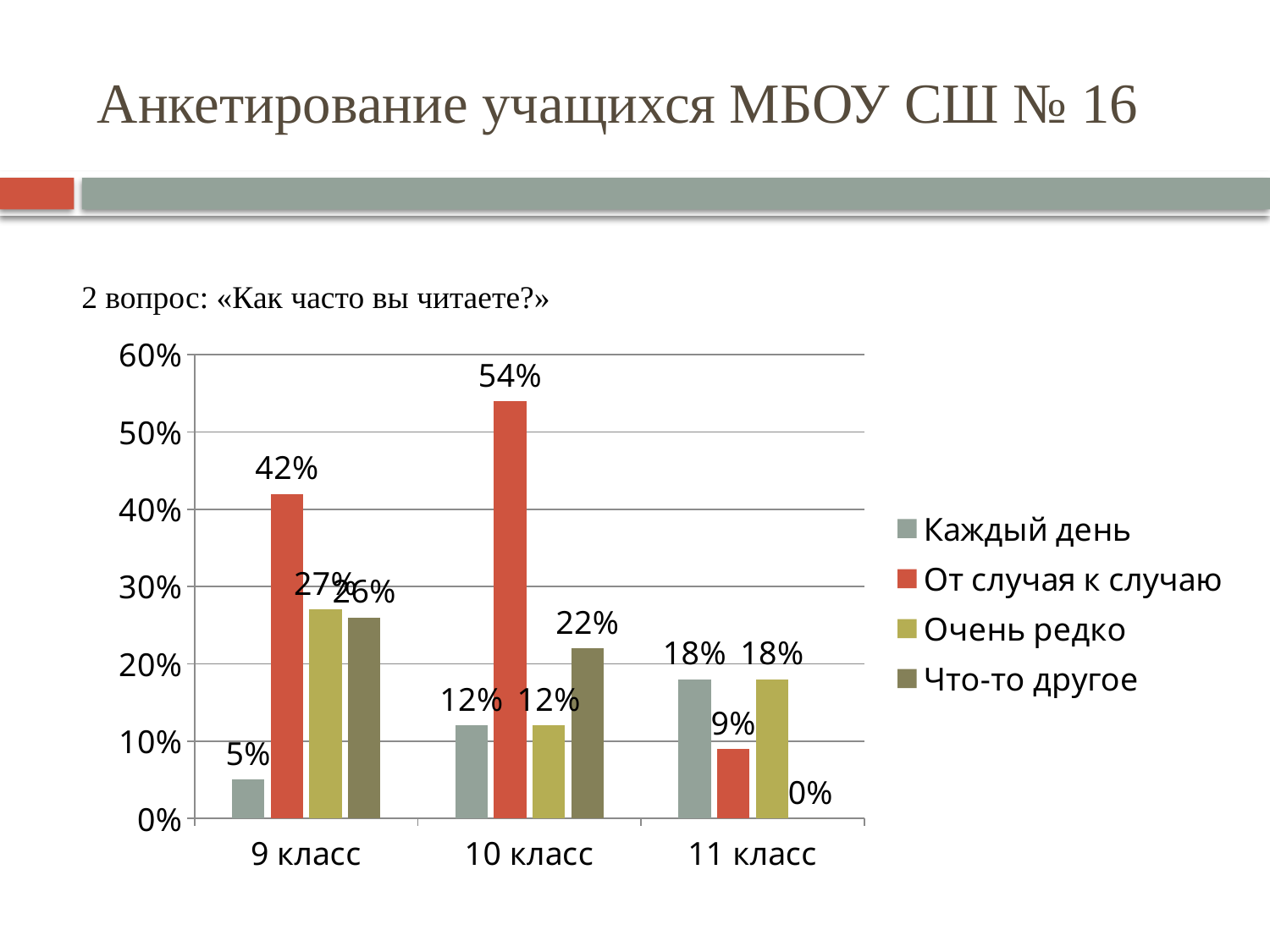
What is the value for «От случая к случаю» in 10 класс? 54% How many classes (categories) are shown on the x axis? 3 What kind of chart is shown on the slide? Bar chart Which class has the lowest value for «Каждый день»? 9 класс What is the value for «Очень редко» in 9 класс? 27% Does the value for «Каждый день» rise or fall from 9 класс to 11 класс? Rise Which class has the highest value for «От случая к случаю»? 10 класс What is the value for «Что-то другое» in 11 класс? 0% How many series does the legend list? 4 What is the value for «Каждый день» in 9 класс? 5% What is the difference between «От случая к случаю» and «Каждый день» in 10 класс? 42% Which is larger in 11 класс: «Каждый день» or «От случая к случаю»? Каждый день